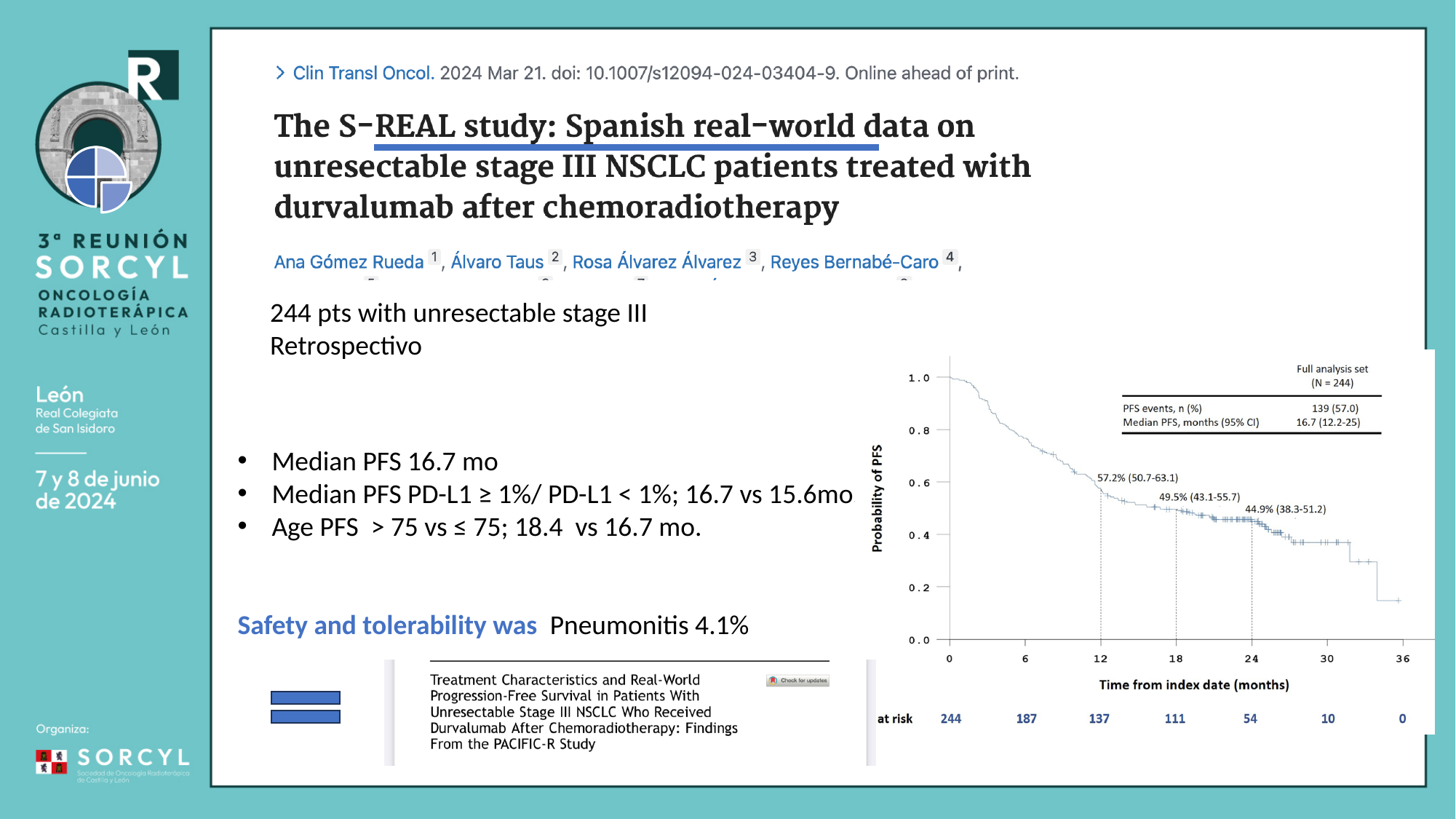
What is the probability of PFS at 12 months according to the label on the curve? 57.2% What is the label of the x axis of the PFS chart? Time from index date (months) What is the difference in percentage points between the PFS probability at 12 months and at 24 months? 12.3 What kind of chart is shown on the right of the slide? line chart Does the probability of PFS rise or fall as time from index date increases? fall How many patients are at risk at time 0 in the PFS chart? 244 What is the median PFS in months shown in the table inside the chart? 16.7 (12.2-25) Is the probability of PFS at 36 months greater or less than 0.2? less What is the probability of PFS at 18 months according to the label on the curve? 49.5% How many patients are at risk at 36 months in the PFS chart? 0 What is the probability of PFS at 24 months according to the label on the curve? 44.9% How many patients are at risk at 24 months in the PFS chart? 54